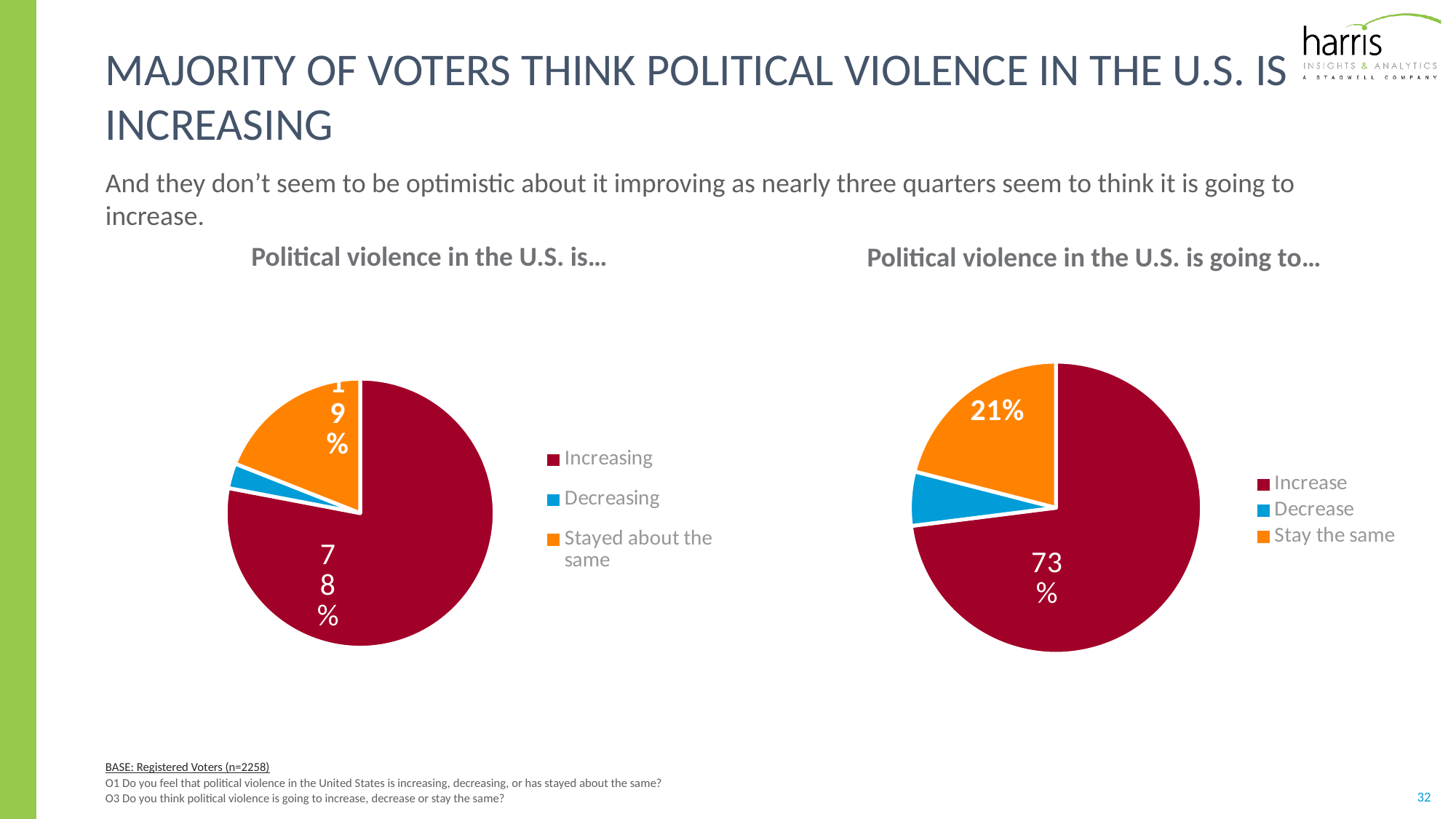
In the left pie chart, which category has the smallest slice? Decreasing In the right pie chart titled "Political violence in the U.S. is going to…", what share of voters say it is going to stay the same? 21% In the left pie chart titled "Political violence in the U.S. is…", what share of voters say it has stayed about the same? 19% In the right pie chart, which category has the smallest slice? Decrease In the left pie chart, which category has the largest slice? Increasing How many categories does the legend of the right pie chart list? 3 In the left pie chart titled "Political violence in the U.S. is…", what share of voters say political violence is increasing? 78% What type of chart is used on the left side of the slide? Pie chart In the right pie chart titled "Political violence in the U.S. is going to…", what share of voters say it is going to increase? 73% In the left pie chart, how many percentage points larger is the Increasing slice than the Stayed about the same slice? 59 Which is larger: the Increasing share in the left pie chart or the Increase share in the right pie chart? Increasing share in the left pie chart In the right pie chart, how many percentage points larger is the Increase slice than the Stay the same slice? 52